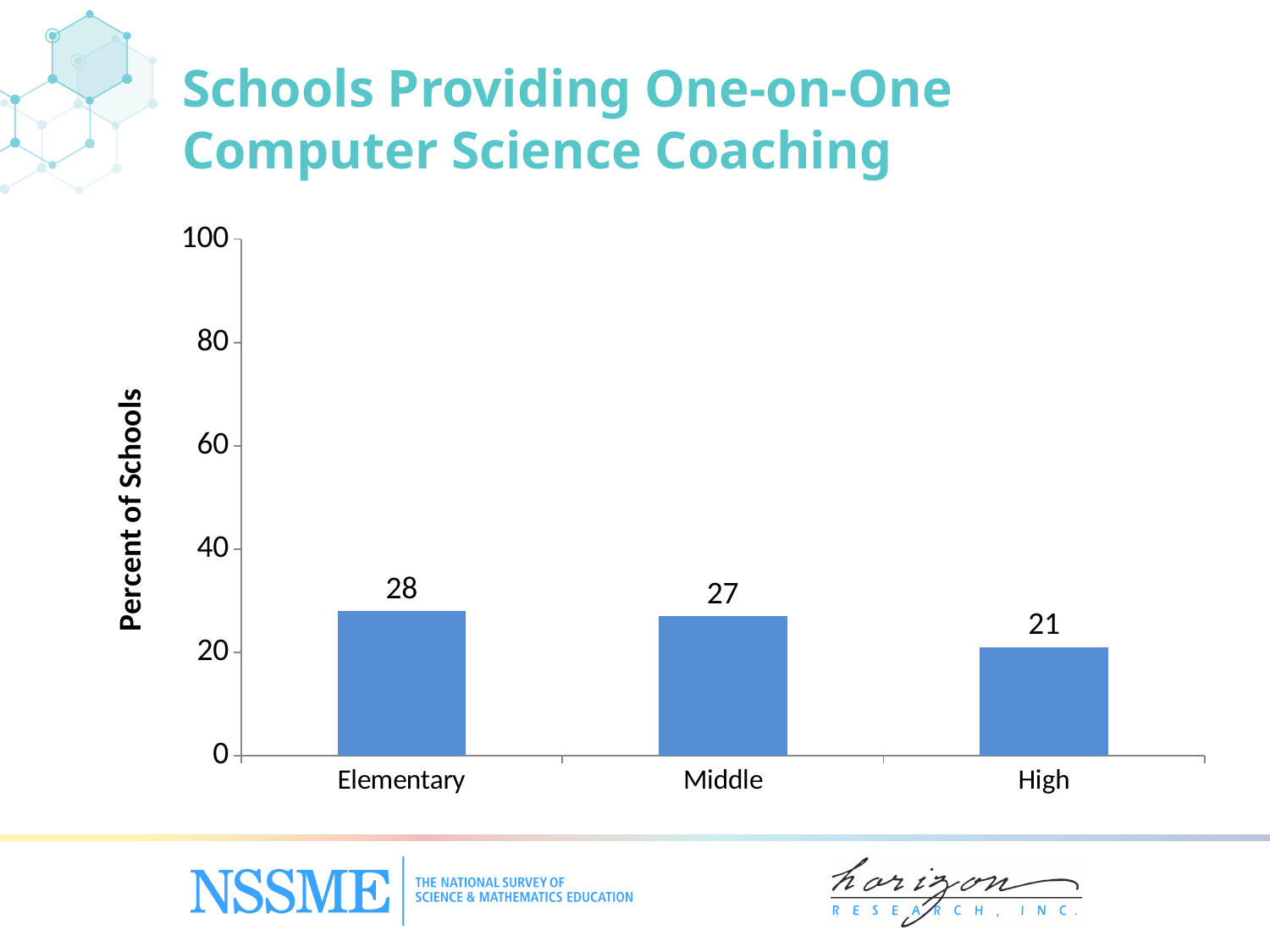
Which school level has the highest percent of schools providing one-on-one computer science coaching? Elementary What is the value for High schools? 21 What is the value for Middle schools? 27 What kind of chart is shown on the slide? bar chart Which school level has the lowest value? High What percent of elementary schools provide one-on-one computer science coaching? 28 Which is larger, the value for Middle or the value for High? Middle What is the label on the vertical axis? Percent of Schools What is the difference between the values for Elementary and High schools? 7 What is the difference between the values for Middle and High schools? 6 How many school levels are shown on the chart? 3 Is the value for Elementary greater or less than 40? less